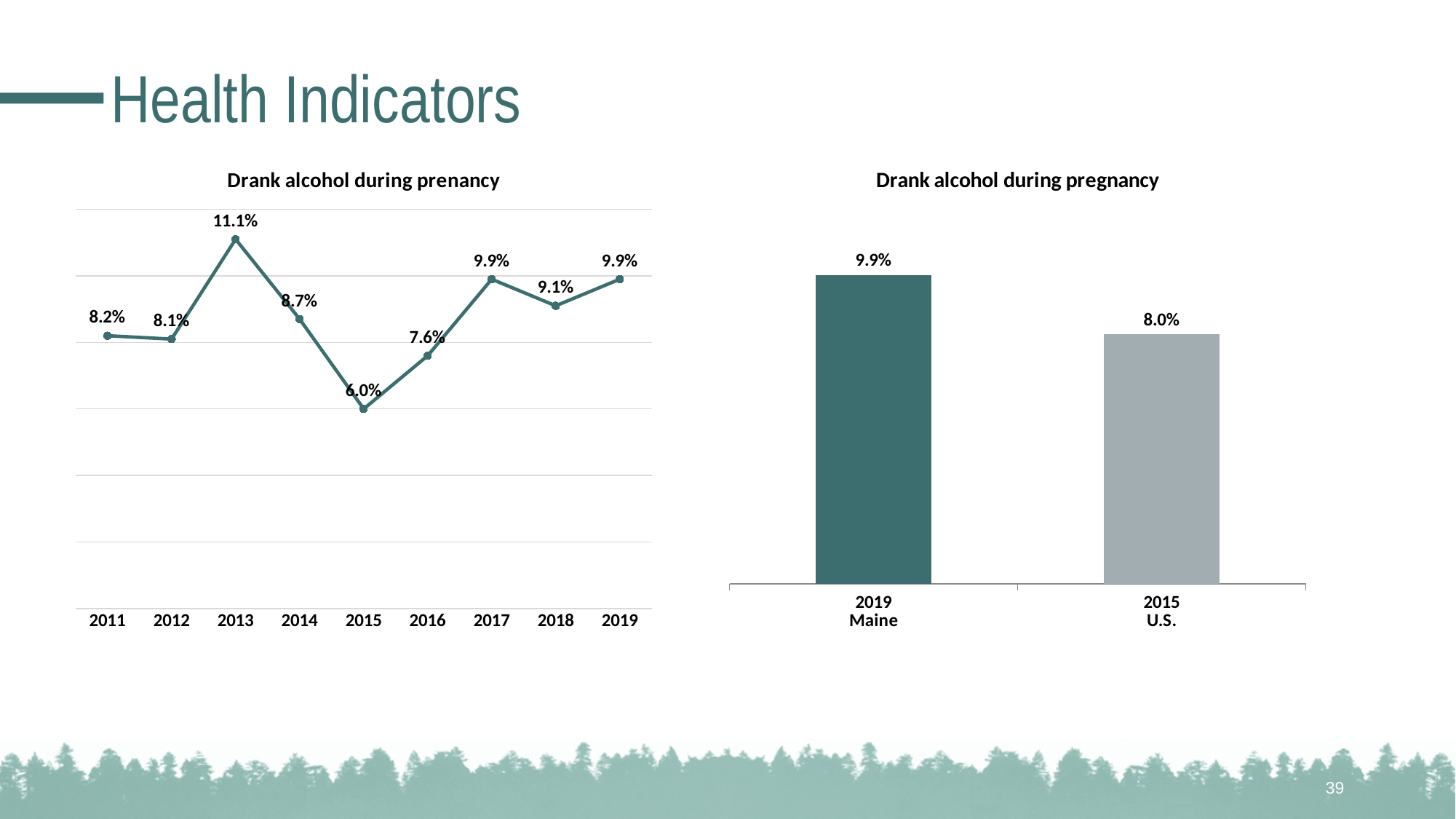
In the left line chart, which year had the highest value? 2013 In the left line chart, which year had the lowest value? 2015 In the right bar chart, what is the value for 2015 U.S.? 8.0% In the left line chart, what is the difference between the 2013 value and the 2015 value? 5.1 percentage points In the left line chart, did the value rise or fall from 2017 to 2018? fall In the left line chart, what was the value for 2013? 11.1% What kind of chart is the chart on the left? line chart In the left line chart, how many years are plotted on the x axis? 9 In the left line chart, what was the value for 2015? 6.0% In the right bar chart, what is the difference between the 2019 Maine value and the 2015 U.S. value? 1.9 percentage points What kind of chart is the chart on the right? bar chart In the right bar chart, which is larger, 2019 Maine or 2015 U.S.? 2019 Maine